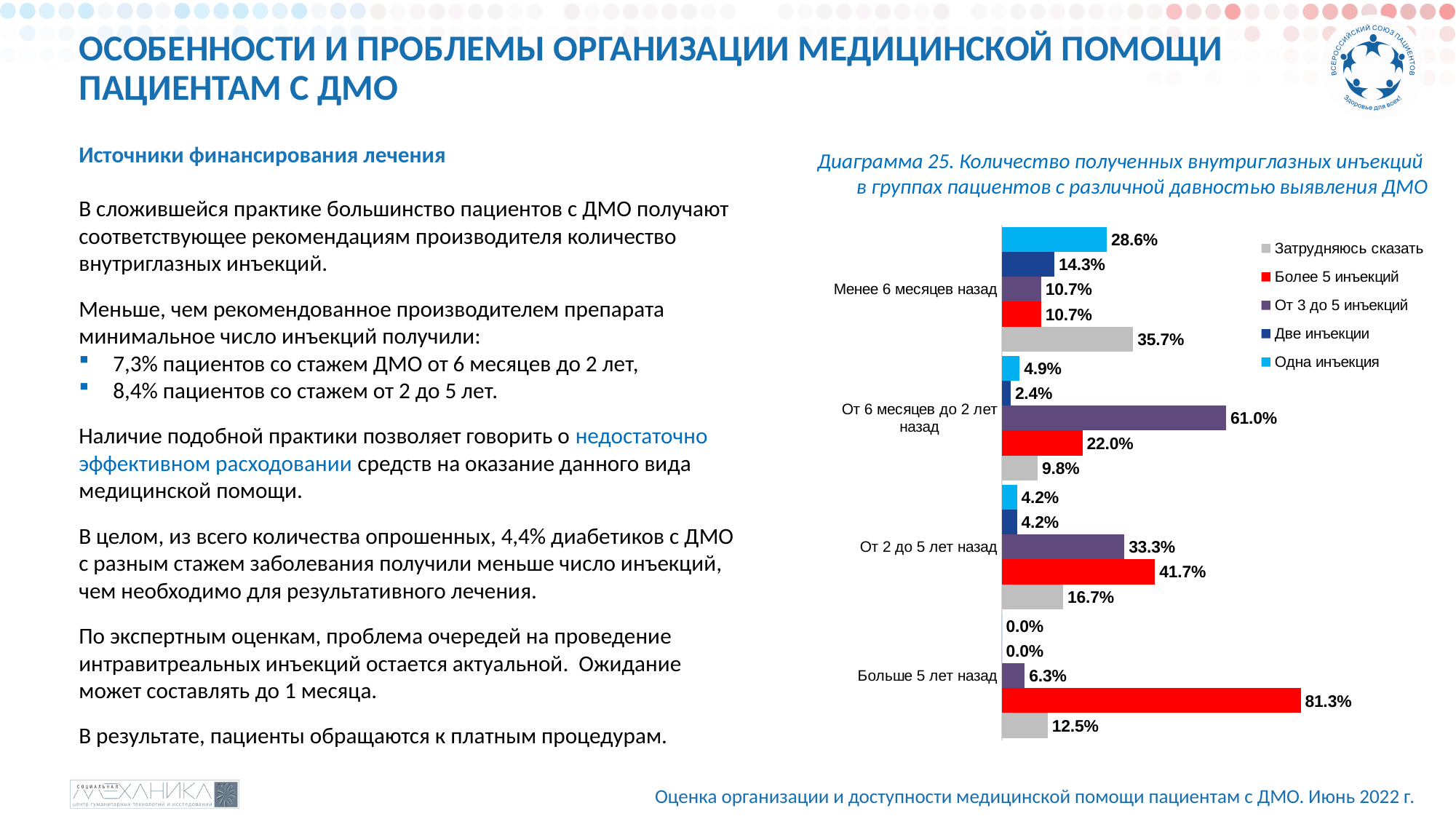
What is the value for 'Более 5 инъекций' in the group 'Больше 5 лет назад'? 81.3% What is the difference between 'Более 5 инъекций' and 'От 3 до 5 инъекций' in the group 'От 2 до 5 лет назад'? 8.4% Which is larger in the group 'От 6 месяцев до 2 лет назад': 'Более 5 инъекций' or 'Затрудняюсь сказать'? Более 5 инъекций What type of chart is shown on the slide? bar chart What is the value for 'От 3 до 5 инъекций' in the group 'От 6 месяцев до 2 лет назад'? 61.0% How many patient groups (categories) are shown on the chart? 4 In which group is the value for 'Более 5 инъекций' the lowest? Менее 6 месяцев назад What is the value for 'Одна инъекция' in the group 'От 2 до 5 лет назад'? 4.2% How many series does the legend list? 5 What is the value for 'Затрудняюсь сказать' in the group 'Менее 6 месяцев назад'? 35.7% In which group is the value for 'Одна инъекция' the highest? Менее 6 месяцев назад What colour represents the series 'Более 5 инъекций' in the legend? red